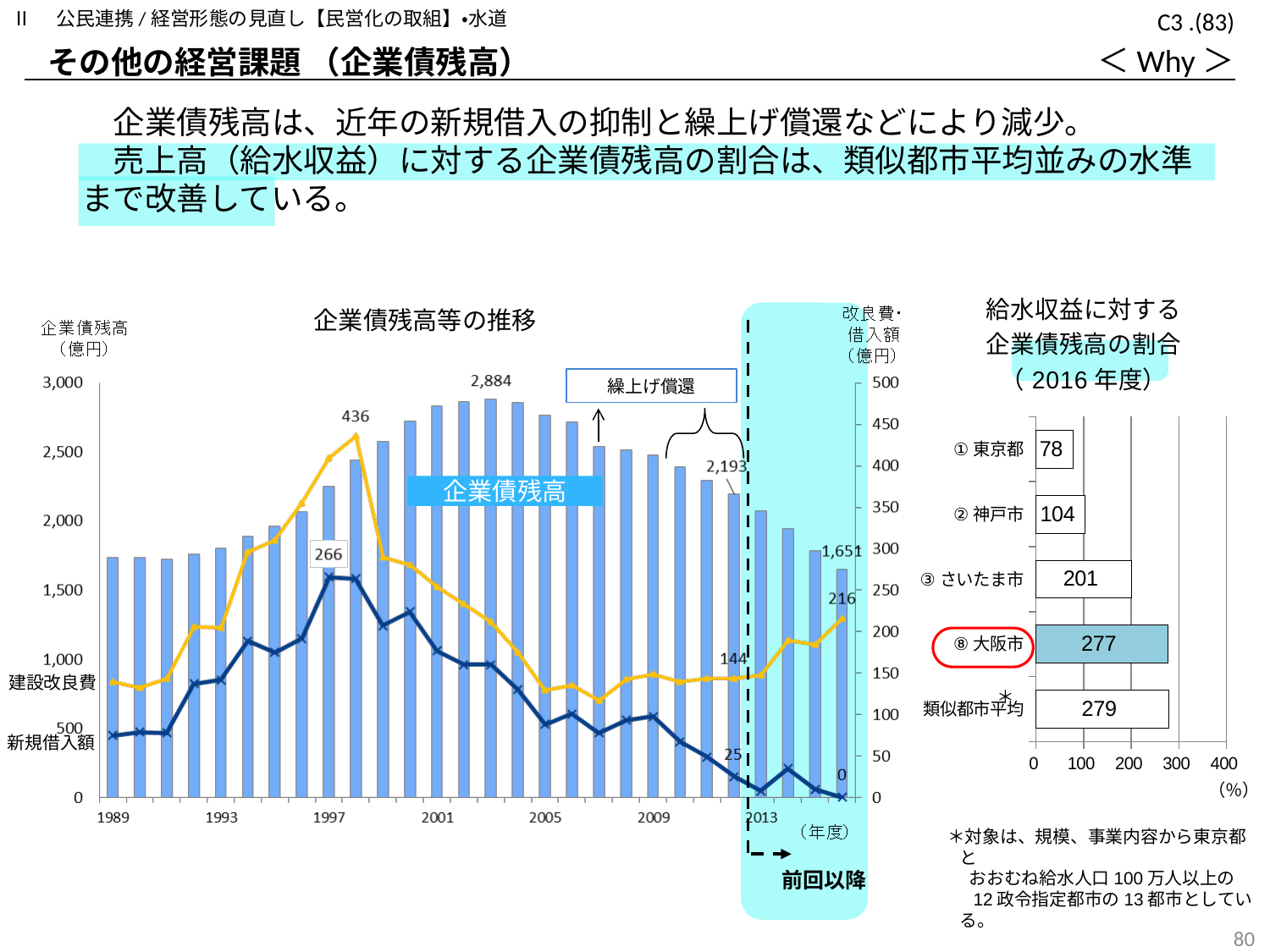
In the chart titled 給水収益に対する企業債残高の割合（2016年度）, what is the value for 大阪市? 277 In the chart titled 給水収益に対する企業債残高の割合（2016年度）, what is the value for 東京都? 78 In the chart titled 企業債残高等の推移, what is the value of 新規借入額 labelled for the last year (2016)? 0 In the chart titled 給水収益に対する企業債残高の割合（2016年度）, which category has the lowest value? 東京都 In the chart titled 企業債残高等の推移, what is the difference between the 企業債残高 values labelled 2,193 and 1,651? 542 What kind of chart is the chart titled 給水収益に対する企業債残高の割合（2016年度）? bar chart In the chart titled 給水収益に対する企業債残高の割合（2016年度）, which is larger, the value for 大阪市 or the value for 神戸市? 大阪市 In the chart titled 企業債残高等の推移, what is the peak value labelled for 企業債残高? 2,884 In the chart titled 企業債残高等の推移, do the 企業債残高 bars rise or fall from 2003 to 2016? fall In the chart titled 給水収益に対する企業債残高の割合（2016年度）, what is the difference between the values for さいたま市 and 神戸市? 97 In the chart titled 企業債残高等の推移, what is the value of 企業債残高 labelled for the last year (2016)? 1,651 How many categories are shown in the chart titled 給水収益に対する企業債残高の割合（2016年度）? 5